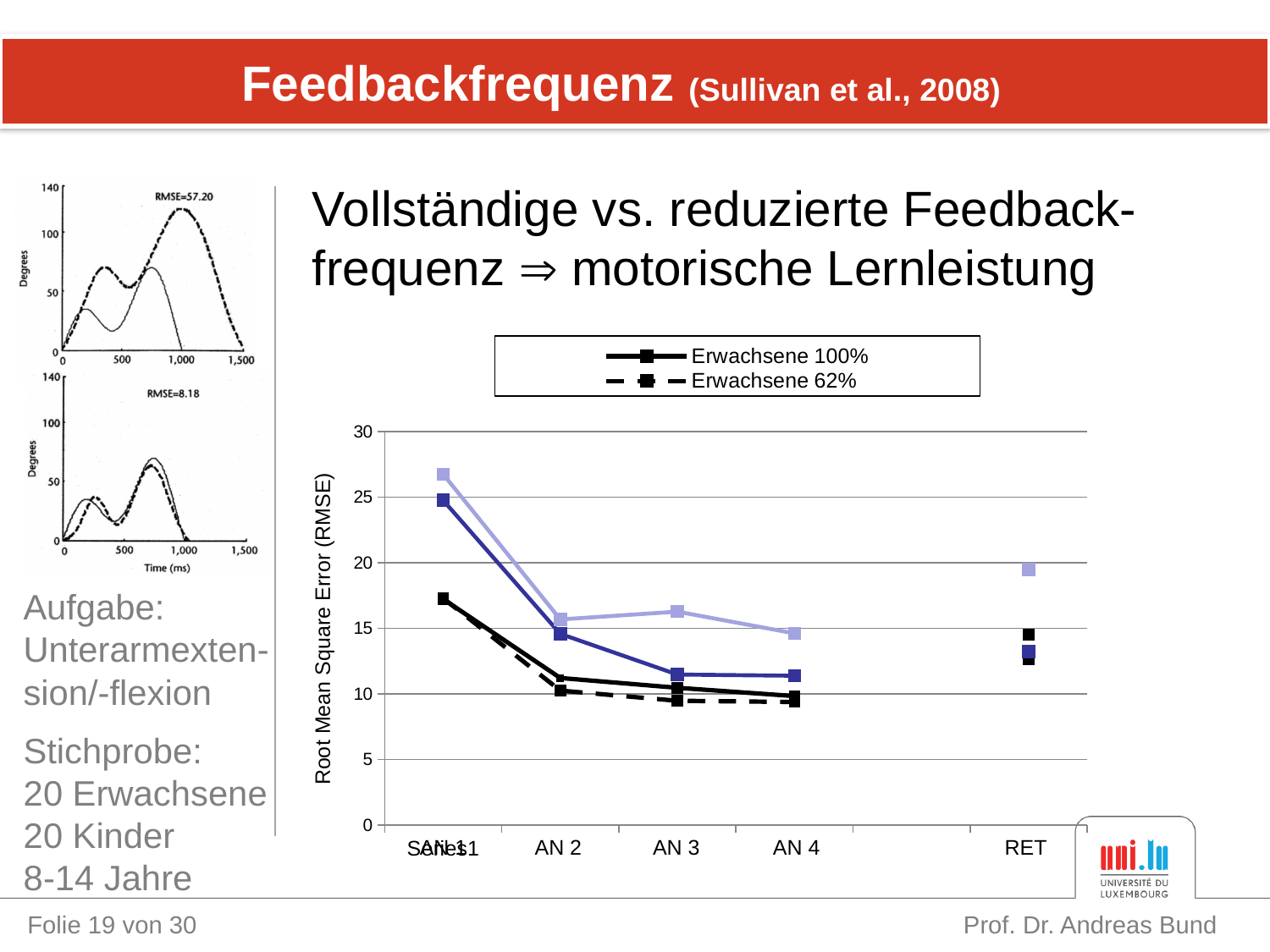
In the large line chart, is the value for Erwachsene 62% at RET greater or less than 10? greater What RMSE value is printed on the top-left small chart? RMSE=57.20 How many series does the legend of the large line chart list? 2 Which two series are named in the legend of the large line chart? Erwachsene 100% and Erwachsene 62% In the large line chart, is the value for Erwachsene 62% at AN 4 greater or less than 10? less What kind of chart is the large chart on the right of the slide? line chart In the large line chart, is the value for Erwachsene 100% at the first point on the x axis greater or less than 15? greater What RMSE value is printed on the bottom-left small chart? RMSE=8.18 What is the y-axis title of the large line chart? Root Mean Square Error (RMSE) In the large line chart, does the Erwachsene 100% series rise or fall from the first point to AN 4? fall